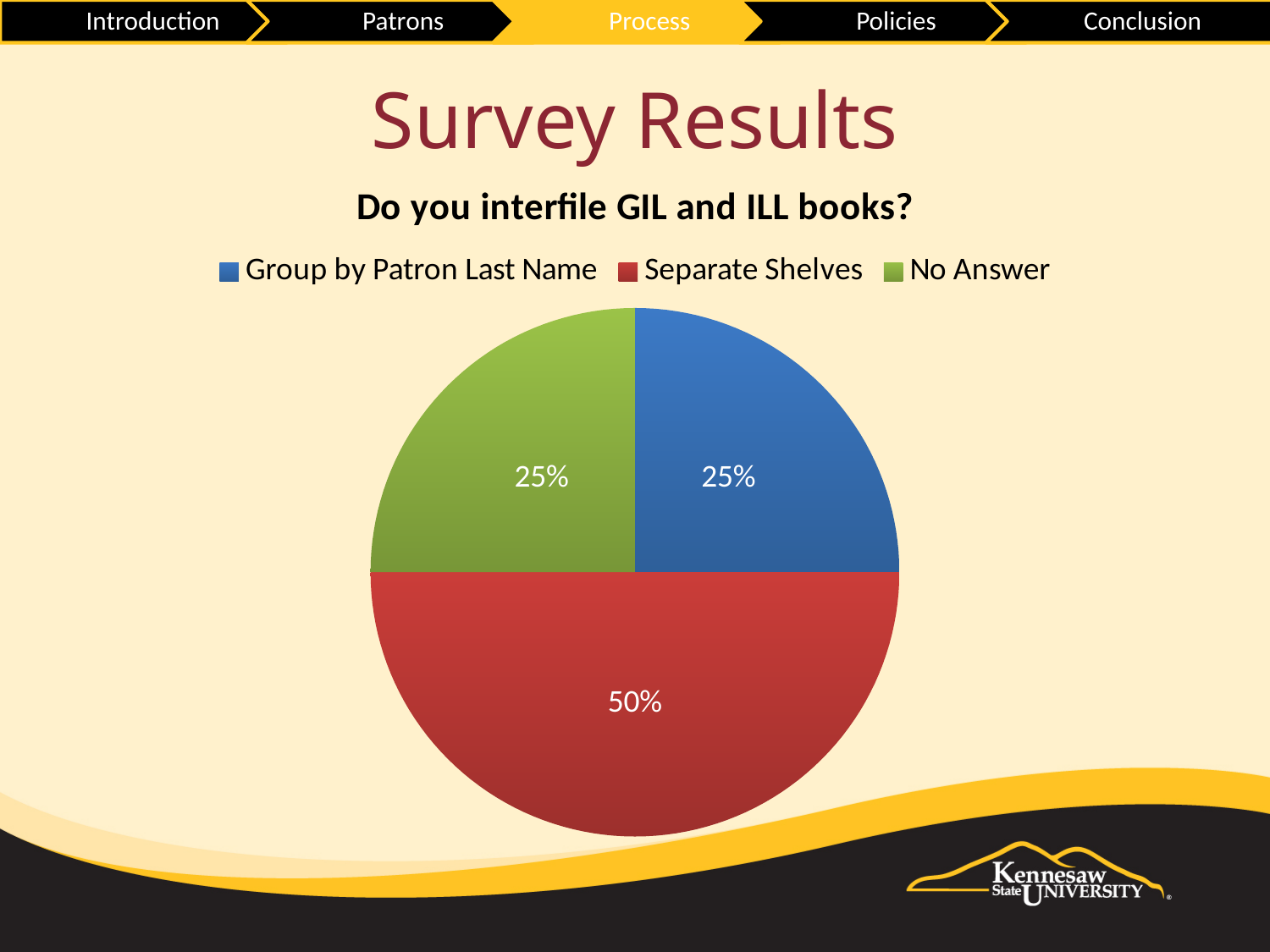
How many categories does the pie chart show? 3 How many entries does the legend list? 3 Which category has the largest slice of the pie? Separate Shelves What share of the pie is labelled for Separate Shelves? 50% What share of the pie is labelled for No Answer? 25% What kind of chart is shown on the slide? Pie chart What is the combined share of Group by Patron Last Name and No Answer? 50% What is the difference between the Separate Shelves share and the No Answer share? 25% What share of the pie is labelled for Group by Patron Last Name? 25% Which colour represents Separate Shelves in the pie chart? Red Which is larger, the Separate Shelves slice or the Group by Patron Last Name slice? Separate Shelves What is the title of the chart? Do you interfile GIL and ILL books?